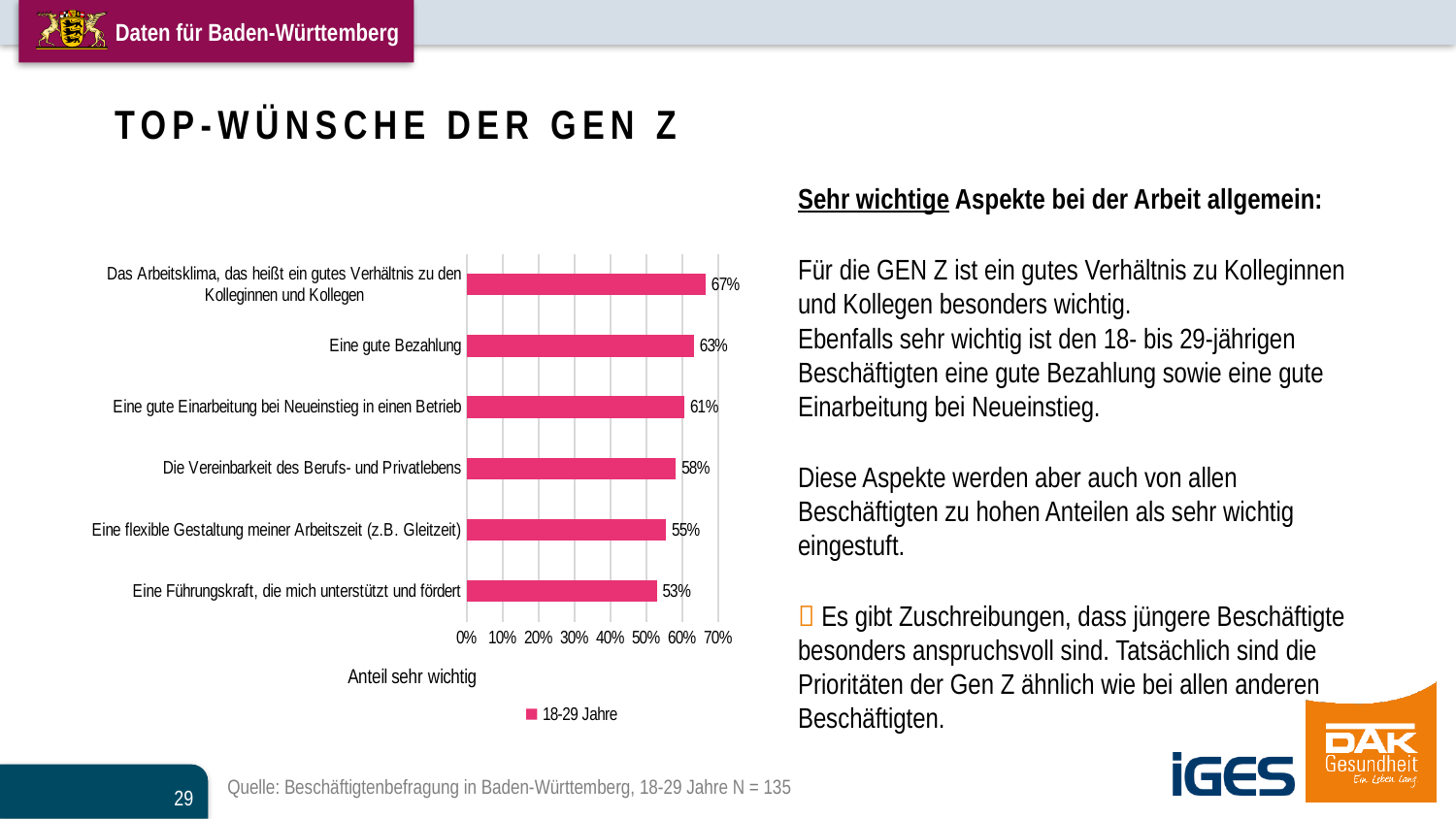
Which category has the highest value? Das Arbeitsklima, das heißt ein gutes Verhältnis zu den Kolleginnen und Kollegen How many categories are shown in the chart? 6 What is the difference between the values for 'Eine gute Bezahlung' and 'Eine flexible Gestaltung meiner Arbeitszeit (z.B. Gleitzeit)'? 8% What is the value for 'Die Vereinbarkeit des Berufs- und Privatlebens'? 58% What is the value for 'Eine gute Bezahlung'? 63% Which category has the lowest value? Eine Führungskraft, die mich unterstützt und fördert Is the value for 'Eine flexible Gestaltung meiner Arbeitszeit (z.B. Gleitzeit)' greater or less than 60%? less What is the value for 'Eine Führungskraft, die mich unterstützt und fördert'? 53% What kind of chart is shown on the slide? bar chart Which is larger: the value for 'Eine gute Einarbeitung bei Neueinstieg in einen Betrieb' or 'Die Vereinbarkeit des Berufs- und Privatlebens'? Eine gute Einarbeitung bei Neueinstieg in einen Betrieb What series name is shown in the chart legend? 18-29 Jahre How many series does the legend list? 1